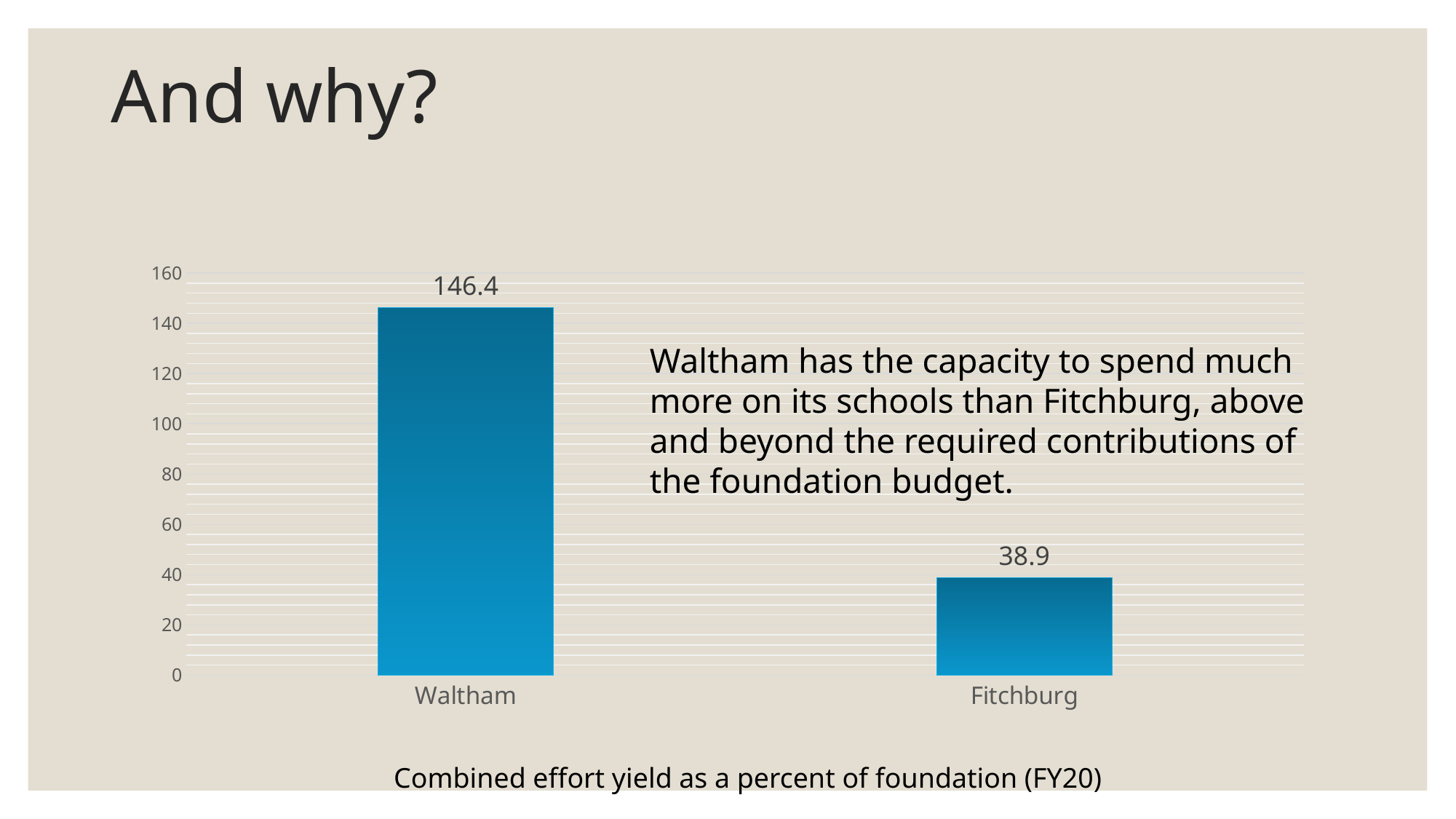
How many categories are shown in the chart? 2 What kind of chart is shown on the slide? bar chart Which category has the highest value? Waltham Is the value for Fitchburg greater or less than 40? less What is the difference between the values for Waltham and Fitchburg? 107.5 What is the value for Waltham? 146.4 What is the value for Fitchburg? 38.9 What is the caption below the chart? Combined effort yield as a percent of foundation (FY20) Which is larger, the value for Waltham or the value for Fitchburg? Waltham Is the value for Waltham greater or less than 140? greater What is the highest value shown on the vertical axis? 160 Which category has the lowest value? Fitchburg